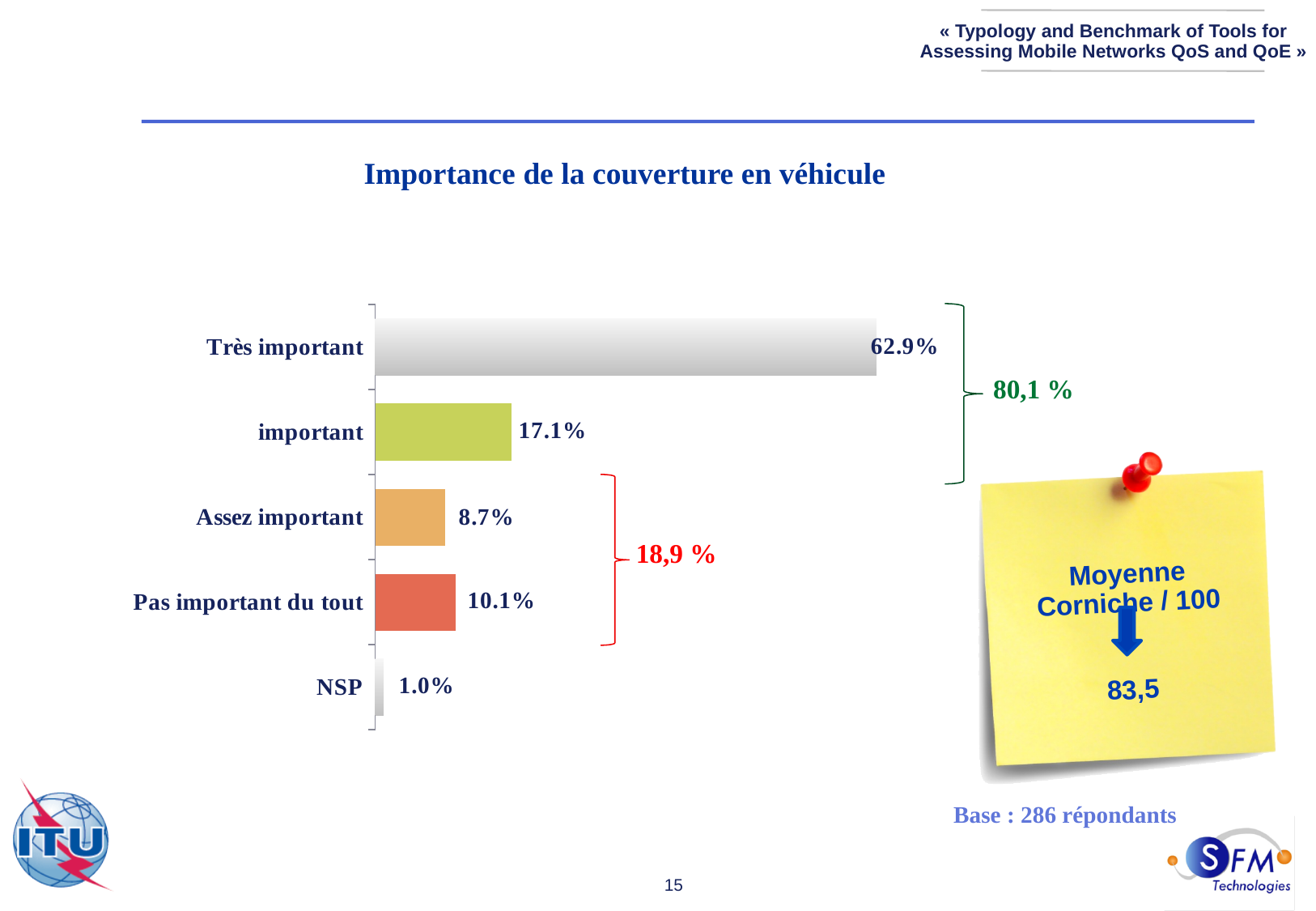
Which category has the lowest value? NSP What is the value for "important"? 17.1% What is the title of the chart? Importance de la couverture en véhicule What is the value for "NSP"? 1.0% Which category has the highest value? Très important What is the value for "Pas important du tout"? 10.1% How many categories are shown in the chart? 5 What is the combined percentage shown by the green bracket for "Très important" and "important"? 80,1 % What is the value for "Très important"? 62.9% Which is larger, the value for "Assez important" or "Pas important du tout"? Pas important du tout What is the difference between the values for "Très important" and "important"? 45.8% What kind of chart is shown on the slide? Bar chart